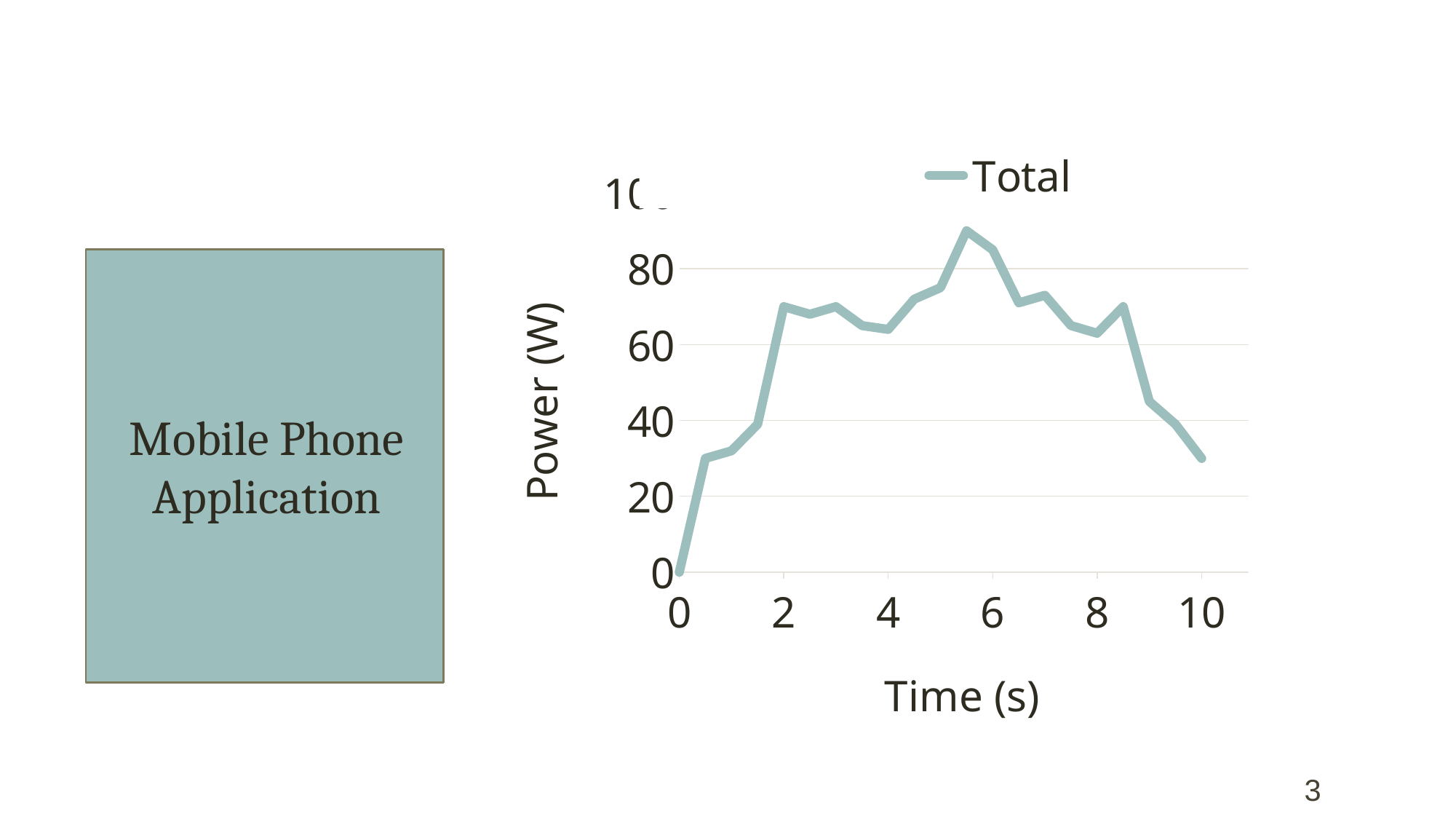
How many series does the chart legend list? 1 Is the value of Total at time 1 s greater or less than 20? greater What is the name of the series shown in the chart legend? Total What kind of chart is shown on the slide? line chart Does the value of Total rise or fall between time 0 s and time 2 s? rise What is the value of Total at time 0 s? 0 Does the value of Total rise or fall between time 8.5 s and time 10 s? fall Is the value of Total at time 9 s greater or less than 60? less Is the value of Total at time 2 s greater or less than 60? greater At what time does Total reach its lowest value? 0 s What is the title of the vertical axis of the chart? Power (W)